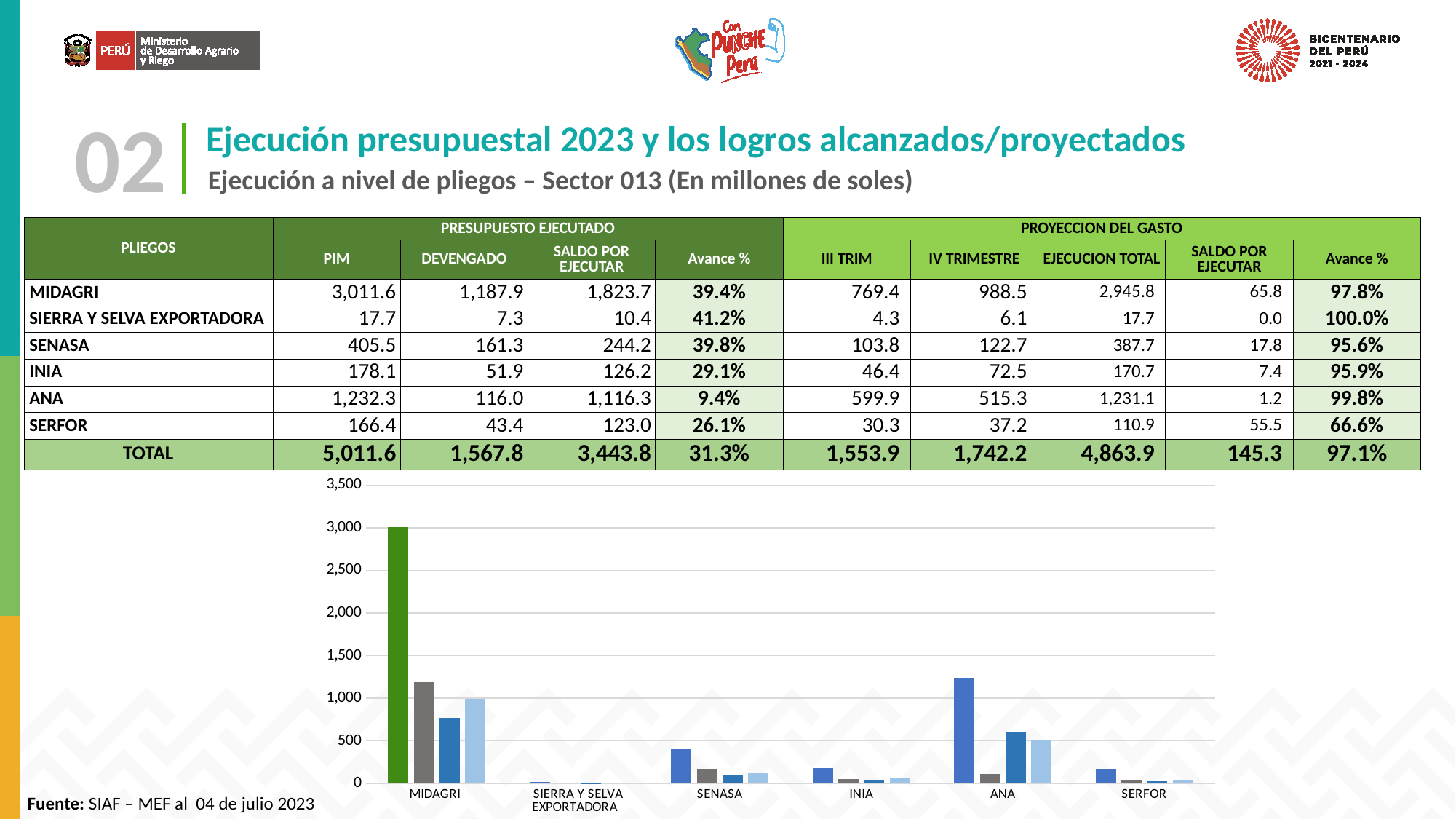
Is the tallest bar for MIDAGRI greater or less than 2,500? greater How many bars are plotted for each category in the bar chart? 4 Which category has a taller tallest bar, MIDAGRI or ANA? MIDAGRI How many categories are shown on the x axis of the bar chart? 6 Which category has a taller tallest bar, SENASA or INIA? SENASA Is the tallest bar for SERFOR greater or less than 500? less Which category has the smallest bars in the bar chart? SIERRA Y SELVA EXPORTADORA Is the tallest bar for SENASA greater or less than 500? less Which category has the tallest bar in the bar chart? MIDAGRI What kind of chart is shown below the table? bar chart What is the highest tick value shown on the y axis of the bar chart? 3,500